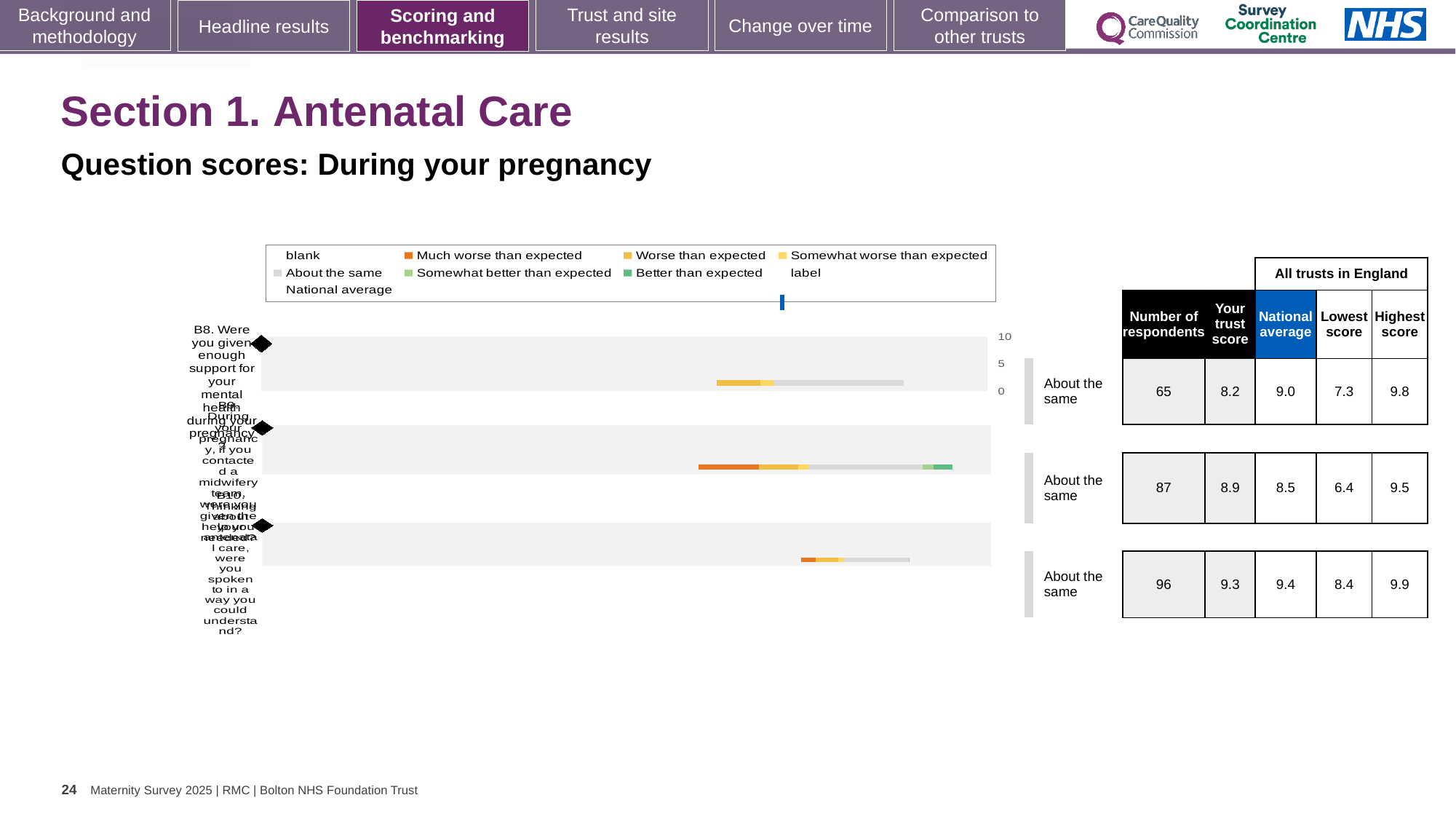
What benchmark category is shown beside each of the three bars? About the same In the table next to the chart, what is the lowest score for the second (middle) question row? 6.4 What kind of chart is shown on the slide? bar chart How many question bars are plotted in the chart? 3 In the table next to the chart, which question row has the highest number of respondents? the third (bottom) row, 96 In the table next to the chart, is the trust score for the second (middle) question row larger or smaller than its national average? larger In the table next to the chart, what is the trust score for question B8 (support for your mental health during pregnancy)? 8.2 In the table next to the chart, what is the highest score for the third (bottom) question row? 9.9 In the table next to the chart, what is the national average for question B8 (support for your mental health during pregnancy)? 9.0 In the chart legend, what colour represents 'Better than expected'? green In the table next to the chart, what is the number of respondents for question B8 (support for your mental health during pregnancy)? 65 In the table next to the chart, what is the difference between the highest score and the lowest score for question B8? 2.5